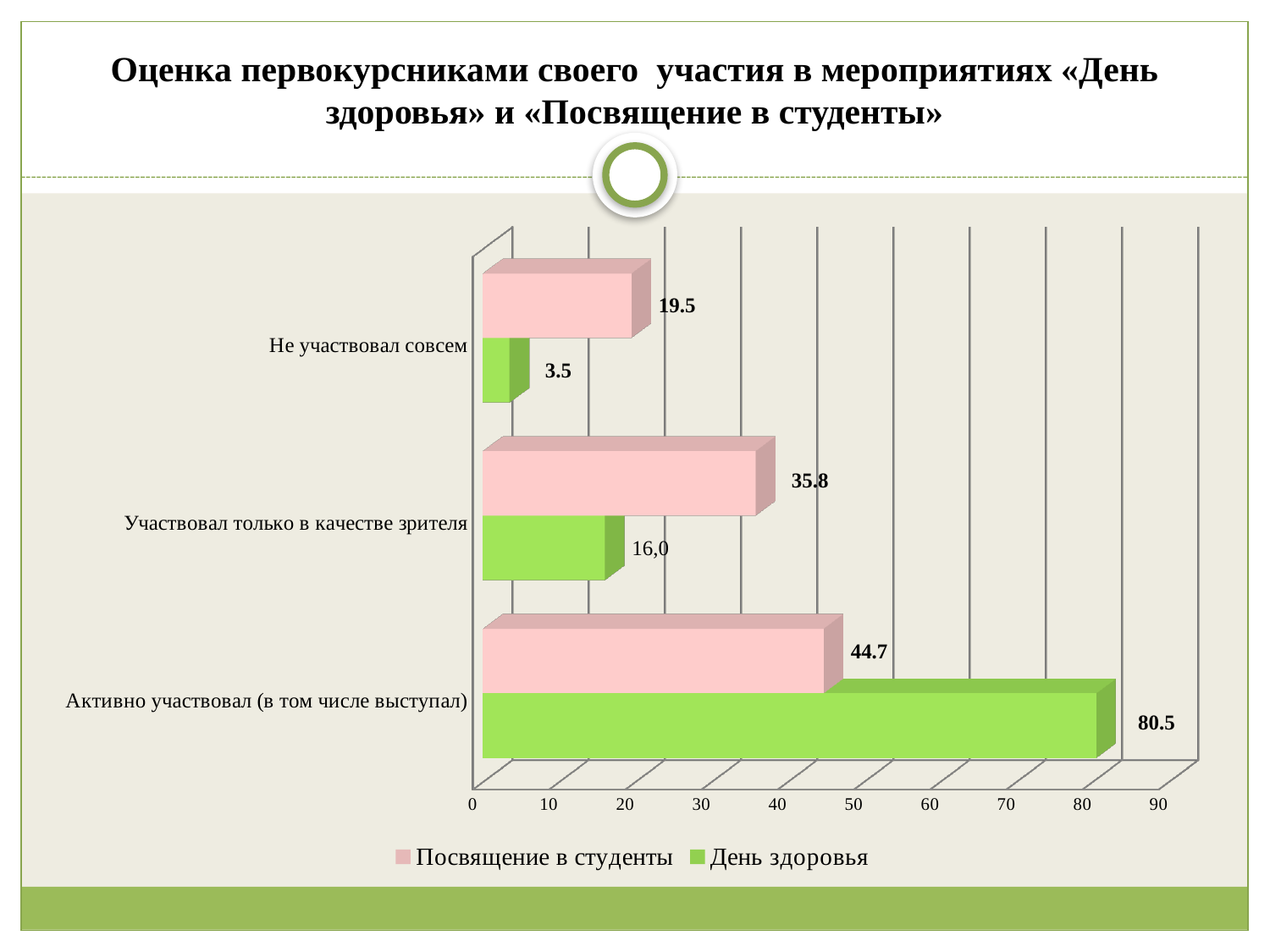
What is the value for «Посвящение в студенты» in the category «Не участвовал совсем»? 19.5 Is the value for «Посвящение в студенты» in «Участвовал только в качестве зрителя» greater or less than 30? greater Which category has the lowest value for the «Посвящение в студенты» series? Не участвовал совсем How many categories are shown on the chart? 3 What is the value for «День здоровья» in the category «Участвовал только в качестве зрителя»? 16,0 What is the difference between the «Посвящение в студенты» and «День здоровья» values for «Не участвовал совсем»? 16 For «Активно участвовал (в том числе выступал)», which series has the larger value: «Посвящение в студенты» or «День здоровья»? День здоровья What kind of chart is shown on the slide? Bar chart Which category has the highest value for the «День здоровья» series? Активно участвовал (в том числе выступал) How many series does the legend list? 2 What is the value for «День здоровья» in the category «Активно участвовал (в том числе выступал)»? 80.5 What is the value for «Посвящение в студенты» in the category «Активно участвовал (в том числе выступал)»? 44.7